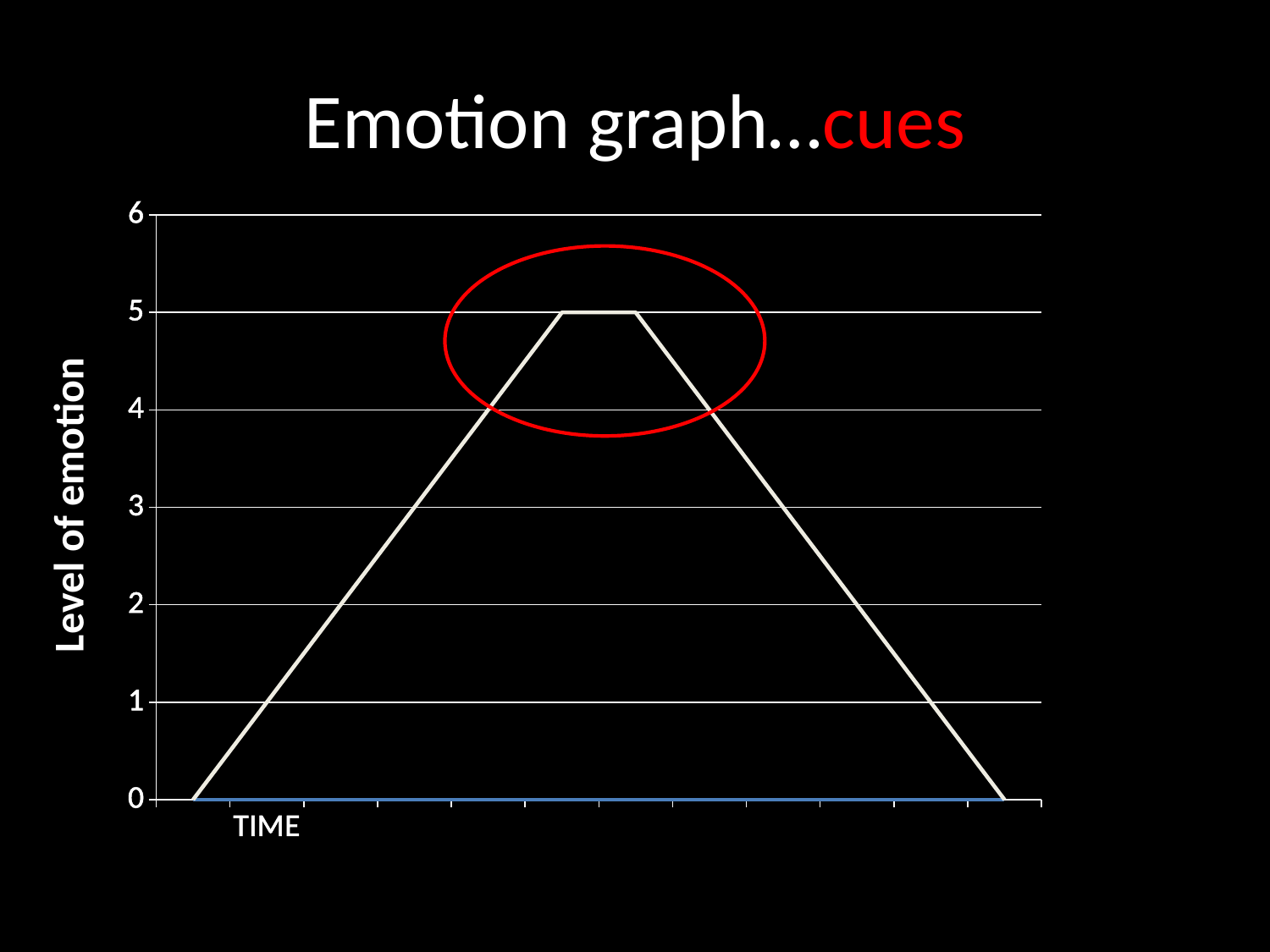
How does the level of emotion change along the time axis? It rises, plateaus, then falls What is the difference between the peak level of emotion and the starting level? 5 What is the label on the horizontal axis? TIME Is the peak value of the line greater or less than 4? greater At what level of emotion does the line start at the beginning of the time axis? 0 What kind of chart is shown on the slide? Line chart What is the highest tick value shown on the vertical axis? 6 What is the highest level of emotion reached by the line? 5 What is the lowest level of emotion shown by the line? 0 Is the peak value of the line greater or less than 6? less What is the label on the vertical axis? Level of emotion At what level of emotion does the line end at the right of the time axis? 0